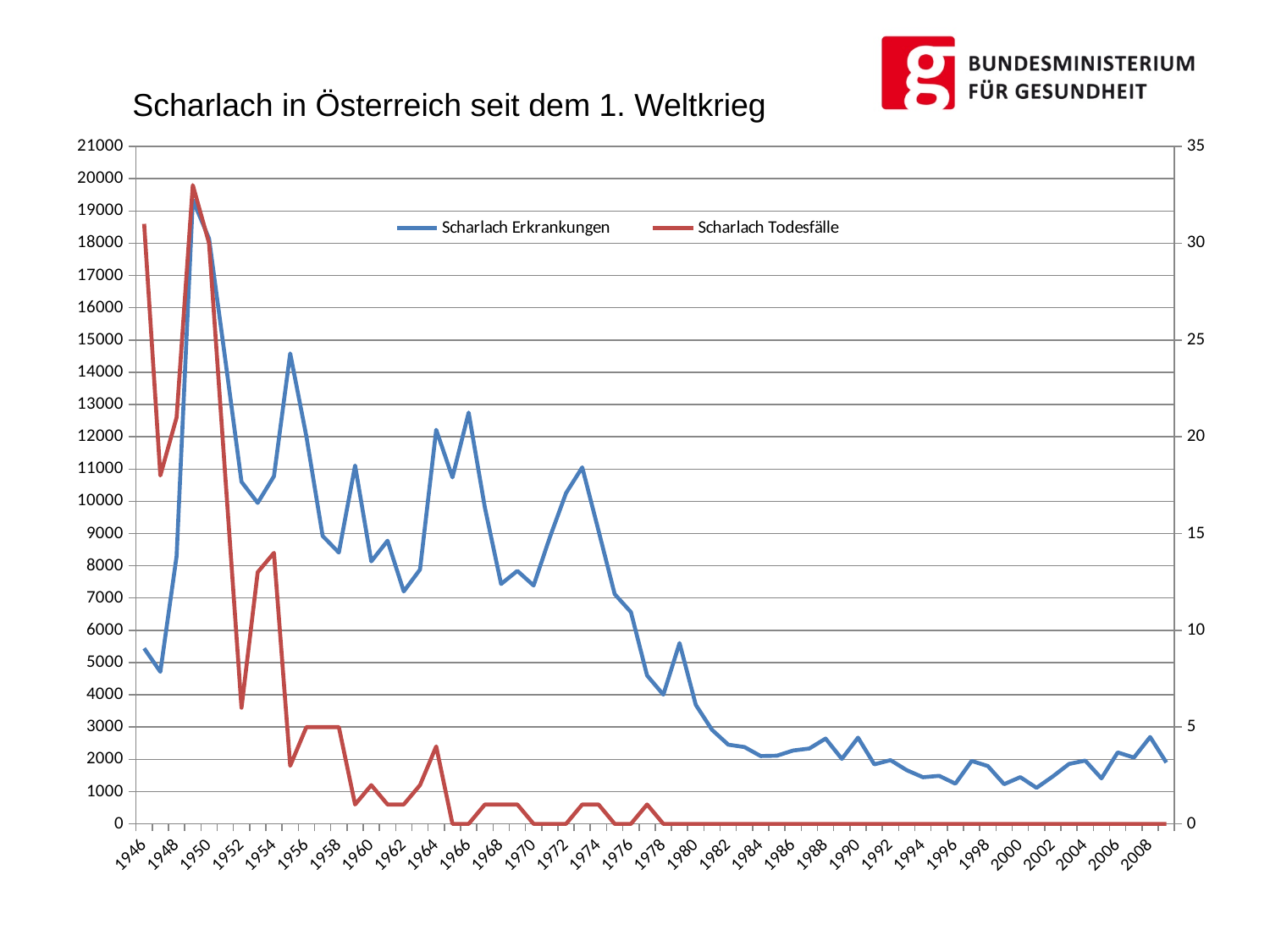
In which year does the Scharlach Erkrankungen series reach its highest value? 1949 In which year does the Scharlach Todesfälle series reach its highest value? 1949 Is the value of Scharlach Erkrankungen in 2008 greater or less than 3000? less What is the value of Scharlach Todesfälle in 2000? 0 Which year has the larger value for Scharlach Erkrankungen, 1955 or 1965? 1955 Is the value of Scharlach Erkrankungen in 1949 greater or less than 18000? greater Does the Scharlach Erkrankungen series generally rise or fall from 1980 to 2008? fall How many series does the legend list? 2 Which colour is used for the Scharlach Todesfälle series? red What is the title of the chart? Scharlach in Österreich seit dem 1. Weltkrieg What is the value of Scharlach Todesfälle in 1957? 5 What kind of chart is shown on the slide? line chart